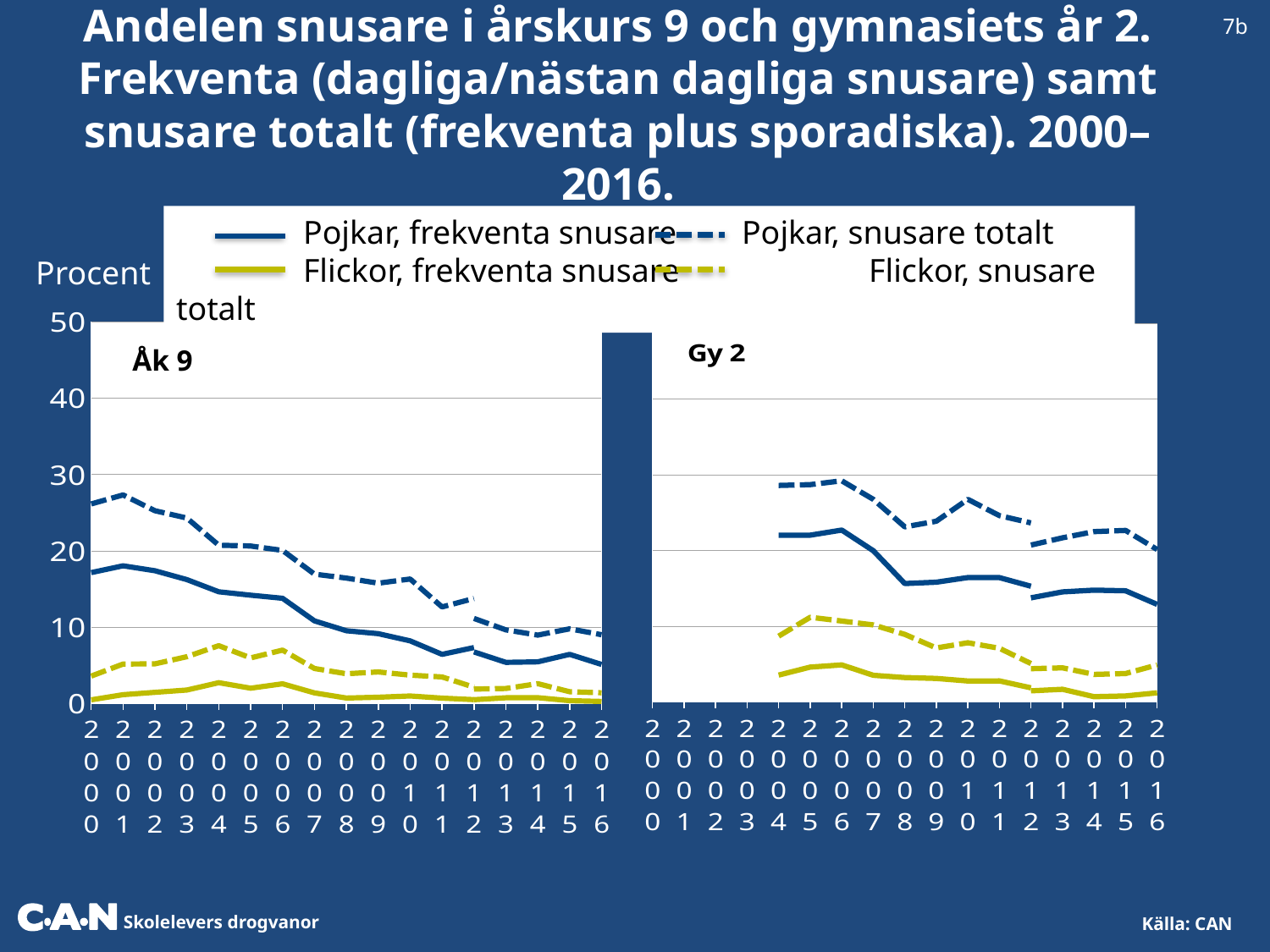
In the Åk 9 chart, which series has the higher value in 2000: Pojkar, frekventa snusare or Flickor, frekventa snusare? Pojkar, frekventa snusare How many series does the legend list? 4 In the Gy 2 chart, does the Pojkar, frekventa snusare series generally rise or fall from 2004 to 2016? Fall In the Gy 2 chart, which series has the higher value in 2016: Pojkar, snusare totalt or Flickor, snusare totalt? Pojkar, snusare totalt In the Åk 9 chart, is the value for Pojkar, frekventa snusare in 2016 greater or less than 10? less In the Åk 9 chart, how many years are shown on the x axis? 17 In the Åk 9 chart, is the value for Pojkar, snusare totalt in 2000 greater or less than 20? greater In the Gy 2 chart, is the value for Pojkar, snusare totalt in 2004 greater or less than 20? greater What is the label on the vertical axis of the charts? Procent What kind of chart is used for the Åk 9 panel on the slide? Line chart In the Åk 9 chart, does the Pojkar, snusare totalt series generally rise or fall from 2000 to 2016? Fall